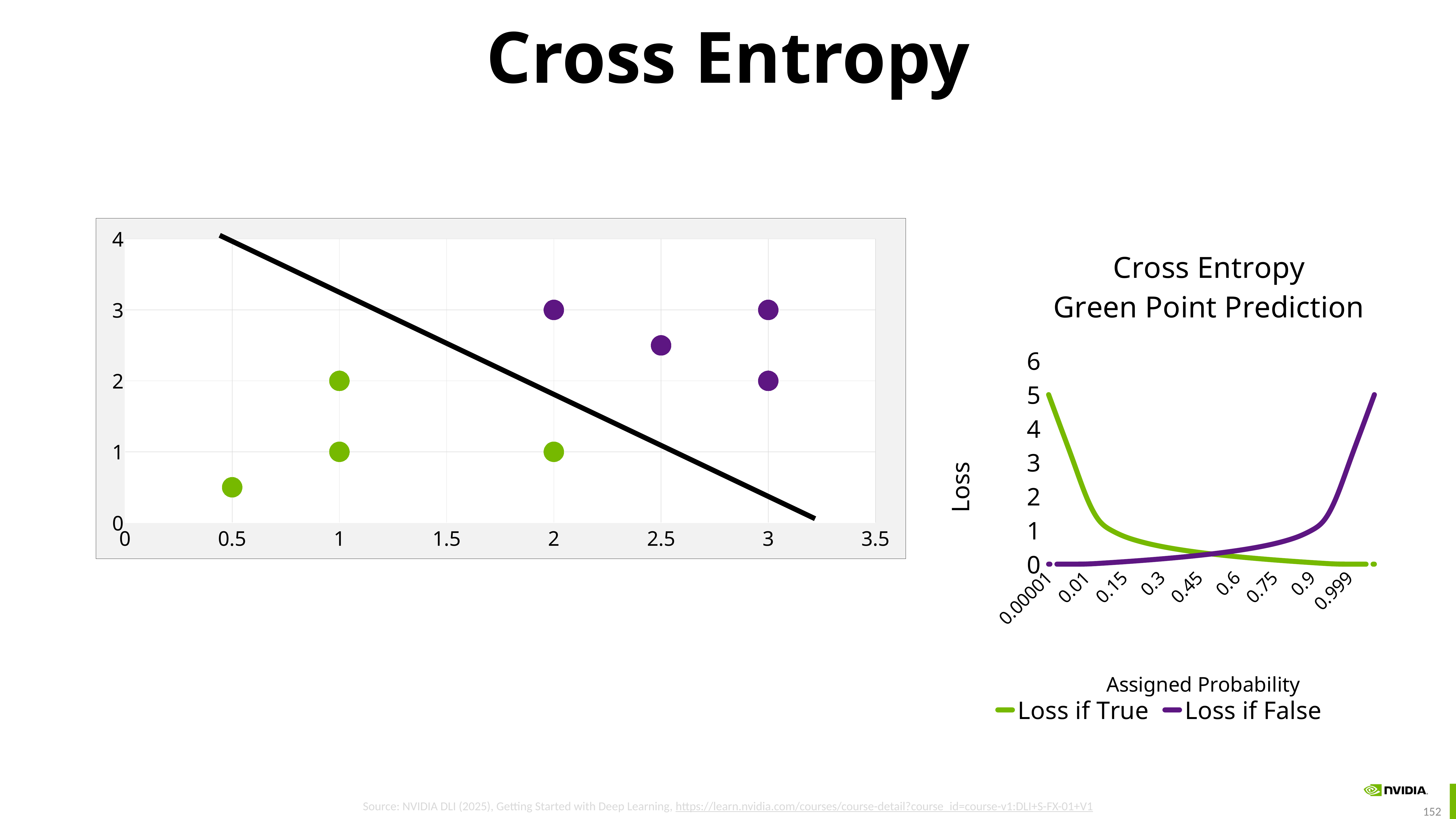
What kind of chart is the chart on the left of the slide? scatter chart In the chart on the right, does the 'Loss if False' line rise or fall as assigned probability increases? rise In the chart on the right, does the 'Loss if True' line rise or fall as assigned probability increases? fall In the chart on the right, at an assigned probability of 0.9, which series has the larger loss, 'Loss if True' or 'Loss if False'? Loss if False In the chart on the right, is the 'Loss if False' value at 0.999 greater or less than 4? greater What kind of chart is the chart on the right titled 'Cross Entropy Green Point Prediction'? line chart In the chart on the right, what are the two legend entries? Loss if True, Loss if False In the chart on the right, how many assigned probability values are labelled on the x axis? 9 In the chart on the right, how many series does the legend list? 2 In the chart on the left, how many purple points are plotted? 4 In the chart on the right, is the 'Loss if True' value at 0.999 greater or less than 1? less